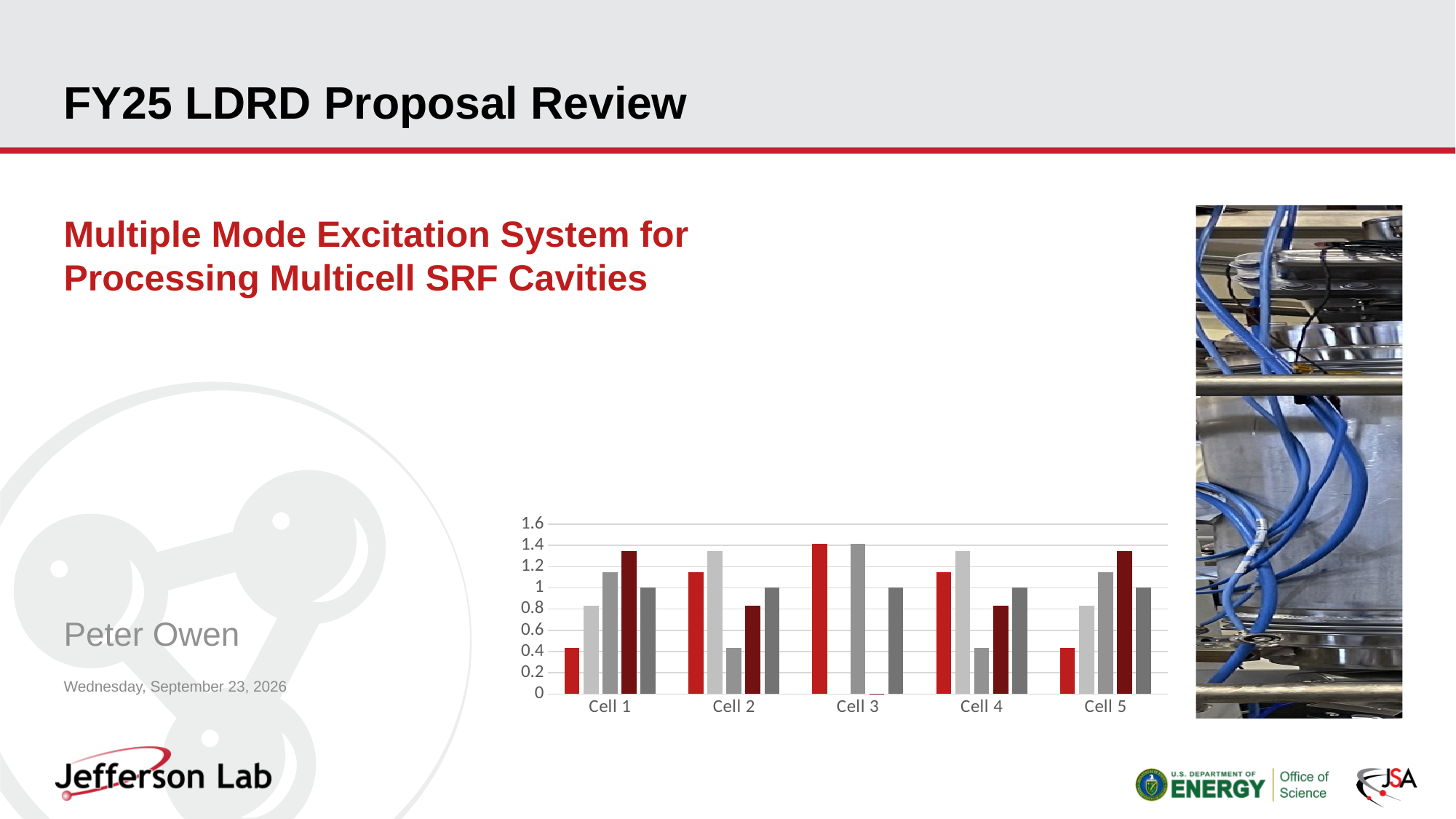
Which is larger for Cell 2: the bright red bar or the dark red bar? the bright red bar How many categories are shown on the x axis of the chart? 5 Is the value of the bright red bar for Cell 1 greater or less than 0.6? less Is the value of the bright red bar for Cell 3 greater or less than 1.2? greater Which is larger for Cell 4: the light gray bar or the dark red bar? the light gray bar Is the value of the light gray bar for Cell 5 greater or less than 1? less What kind of chart is shown on the slide? bar chart How many bars are plotted for each cell in the chart? 5 Which cell has the tallest bright red bar? Cell 3 What is the highest value shown on the y axis of the chart? 1.6